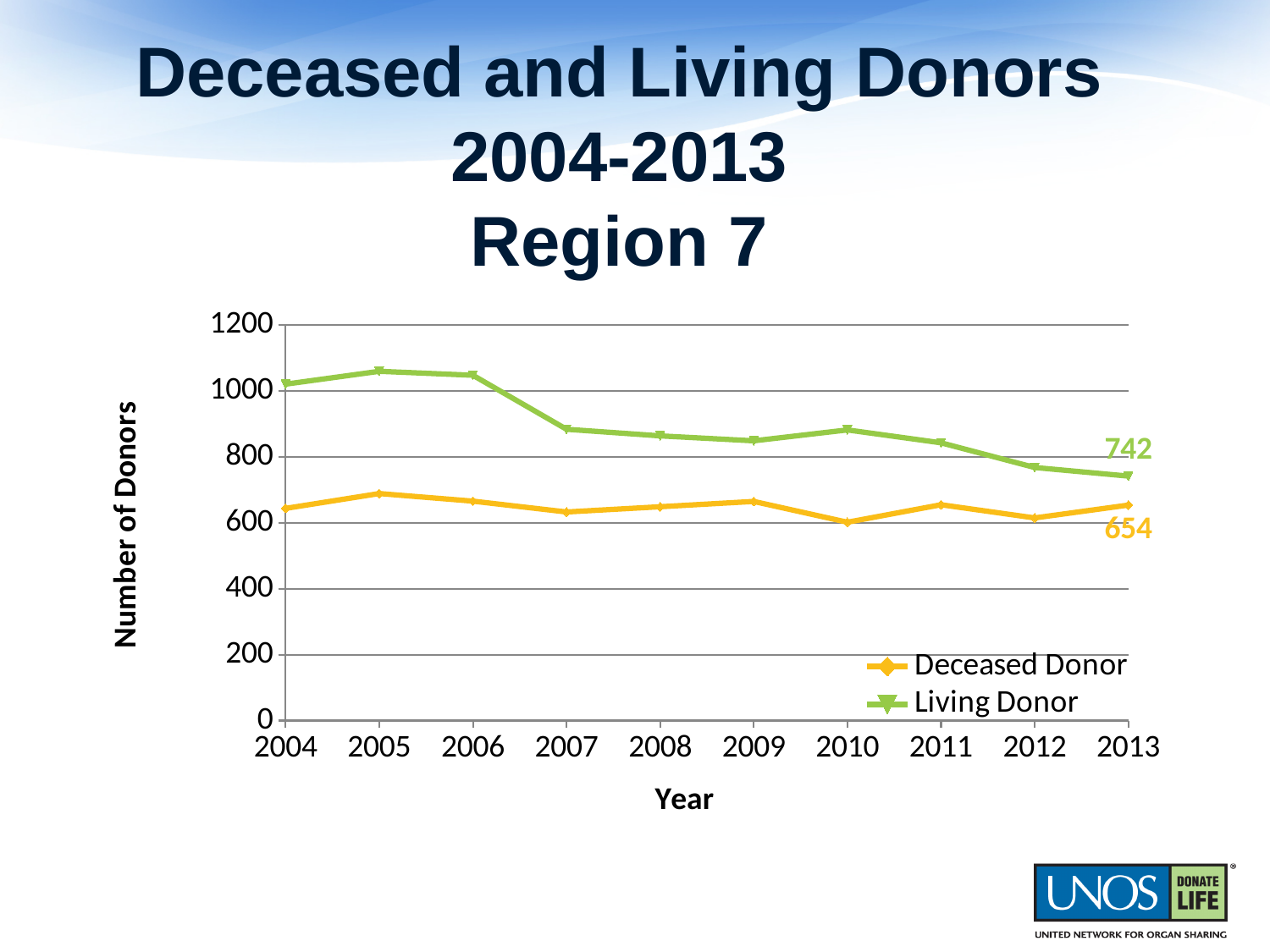
How many series does the legend list? 2 Is the value for Living Donor in 2005 greater or less than 1000? greater In which year is the Living Donor value lowest? 2013 What kind of chart is shown on the slide? line chart How many years are shown on the x axis? 10 In which year is the Living Donor value highest? 2005 What is the difference between the Living Donor and Deceased Donor values in 2013? 88 In 2013, which series has the larger value, Living Donor or Deceased Donor? Living Donor Is the value for Living Donor in 2007 greater or less than 1000? less What is the value for Deceased Donor in 2013? 654 Is the value for Deceased Donor in 2010 greater or less than 800? less What is the value for Living Donor in 2013? 742